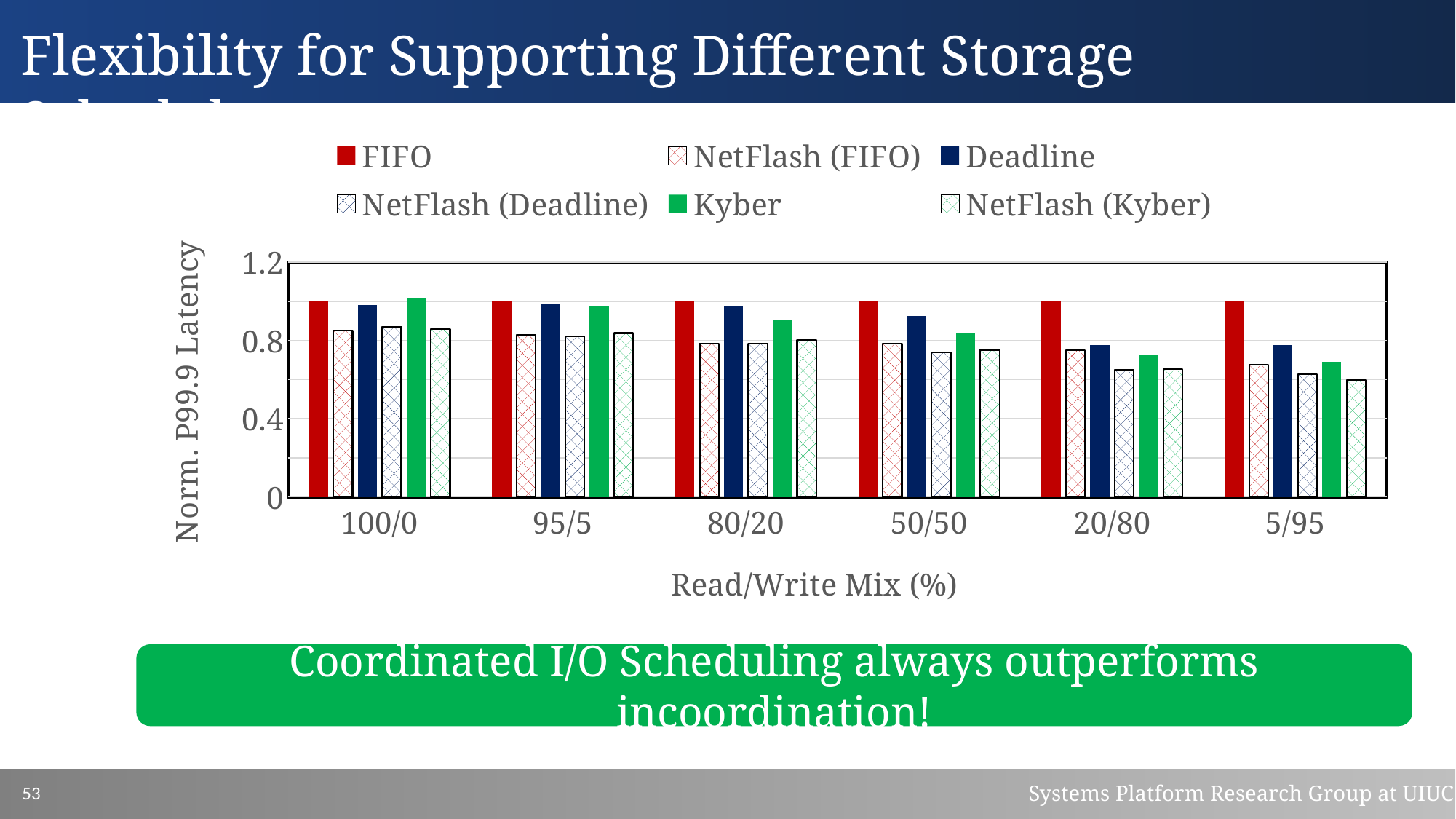
How many series does the legend list? 6 Do the NetFlash (Kyber) values rise or fall moving from 100/0 to 5/95 along the x axis? fall At 5/95, which is larger: Kyber or NetFlash (Kyber)? Kyber What is the title of the x axis? Read/Write Mix (%) Is the value for FIFO at 100/0 greater or less than 0.8? greater What kind of chart is shown on the slide? bar chart Is the value for NetFlash (Kyber) at 5/95 greater or less than 0.8? less What is the title of the y axis? Norm. P99.9 Latency At 100/0, which is larger: FIFO or NetFlash (FIFO)? FIFO Is the value for Kyber at 100/0 greater or less than 0.8? greater How many read/write mix categories are shown on the x axis? 6